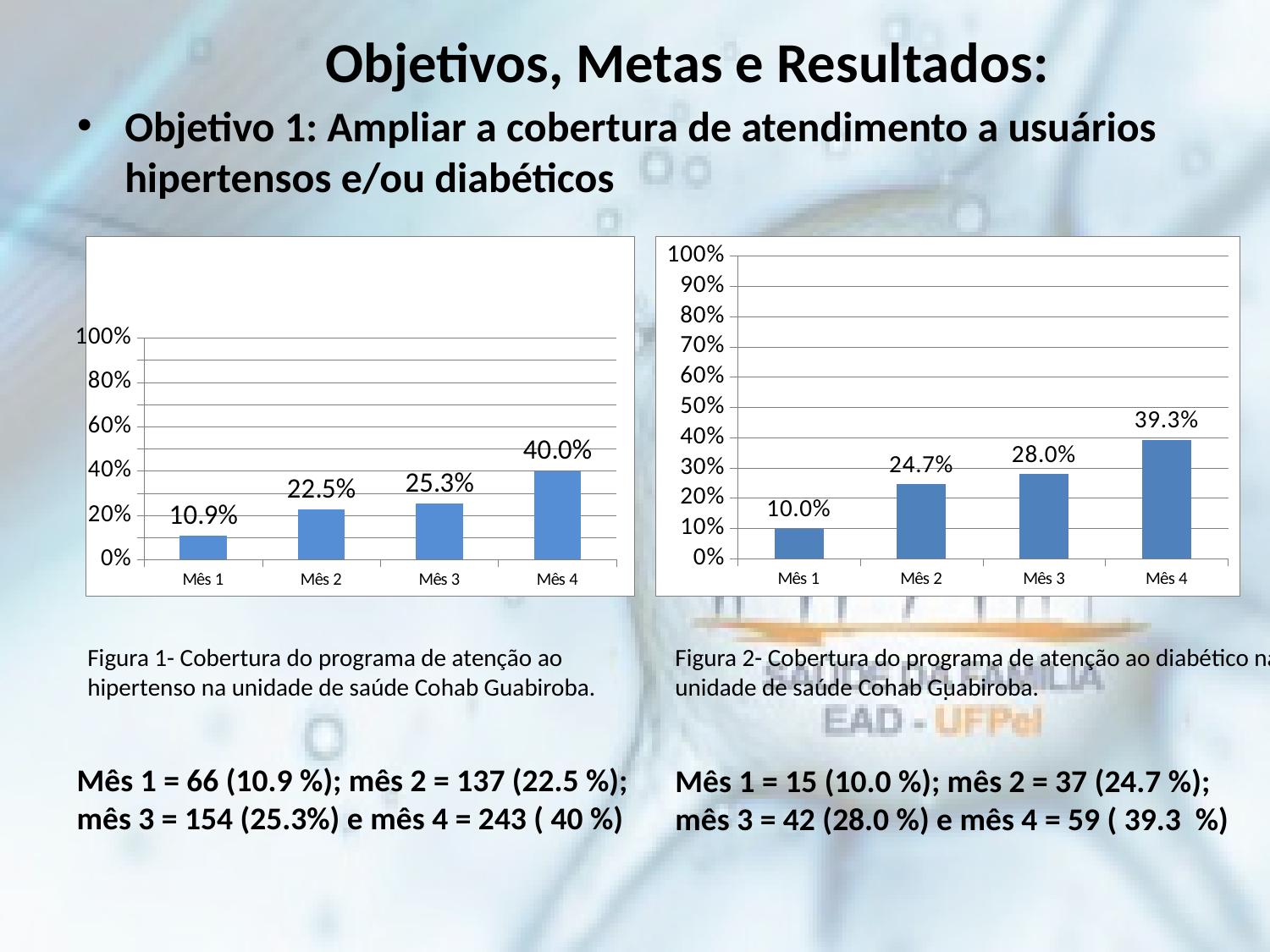
What kind of chart is the right chart (Figura 2, diabético)? Bar chart How many categories (months) are shown in the left chart (Figura 1, hipertenso)? 4 In the left chart (Figura 1, hipertenso), is the value for Mês 4 greater or less than 20%? greater In the left chart (Figura 1, hipertenso), what is the difference between the values for Mês 4 and Mês 3? 14.7% In the left chart (Figura 1, hipertenso), which month has the highest value? Mês 4 In the left chart (Figura 1, hipertenso), what is the value for Mês 2? 22.5% In the right chart (Figura 2, diabético), what is the value for Mês 4? 39.3% In the right chart (Figura 2, diabético), which is larger, the value for Mês 2 or Mês 3? Mês 3 In the right chart (Figura 2, diabético), which month has the lowest value? Mês 1 In the right chart (Figura 2, diabético), what is the difference between the values for Mês 2 and Mês 1? 14.7% In the right chart (Figura 2, diabético), do the values rise or fall from Mês 1 to Mês 4? Rise In the left chart (Figura 1, hipertenso), what is the value for Mês 1? 10.9%